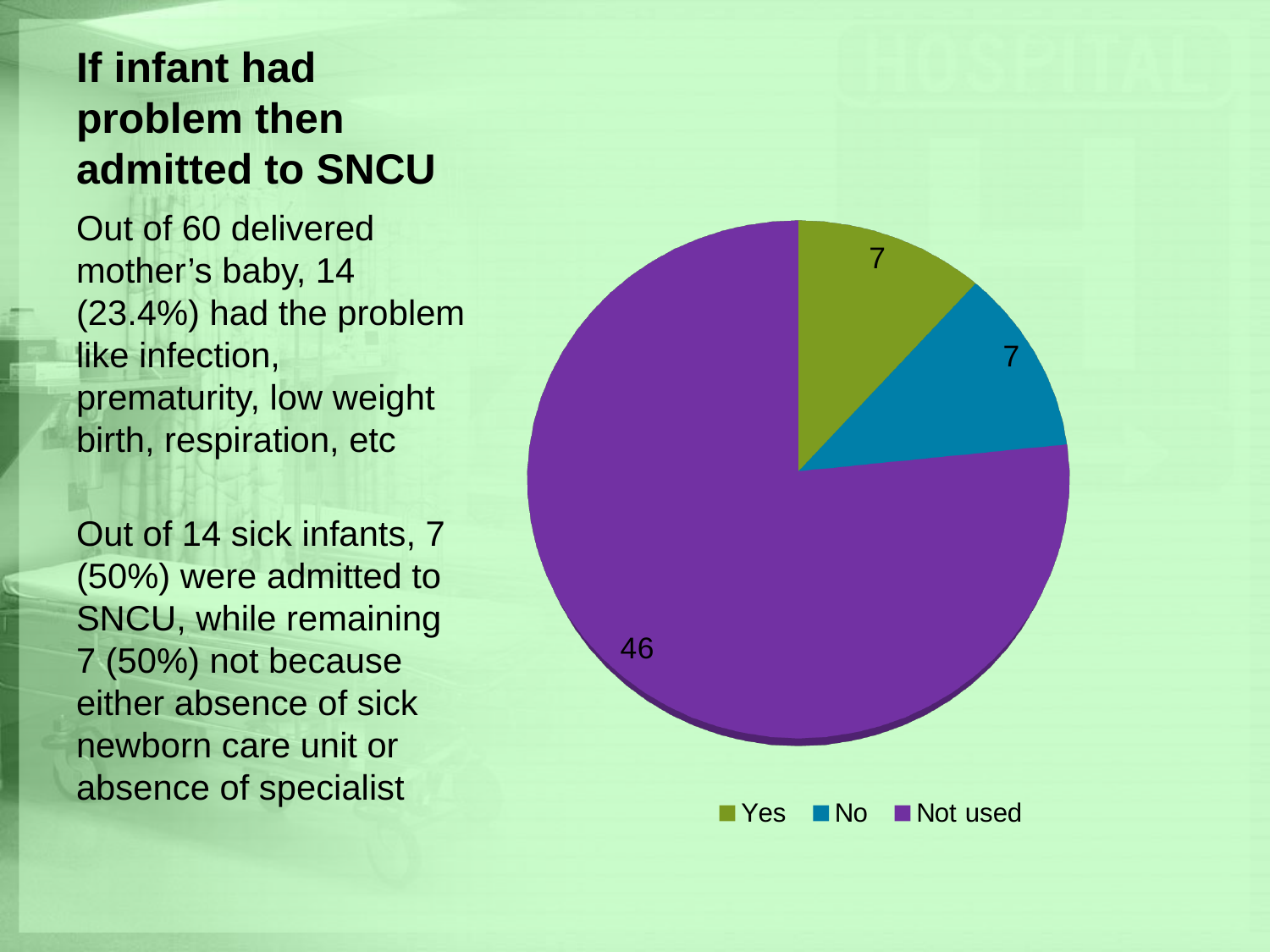
What is the value for the 'Not used' slice? 46 What is the value for the 'Yes' slice? 7 What colour is the 'Yes' slice? green What is the total of all slices in the pie chart? 60 How many slices does the pie chart have? 3 Is the value for 'Not used' larger than the value for 'No'? Yes How many categories does the legend list? 3 What colour is the 'Not used' slice? purple What is the value for the 'No' slice? 7 Which category has the largest slice of the pie? Not used What type of chart is shown on the slide? pie chart What is the difference between the 'Not used' value and the 'Yes' value? 39